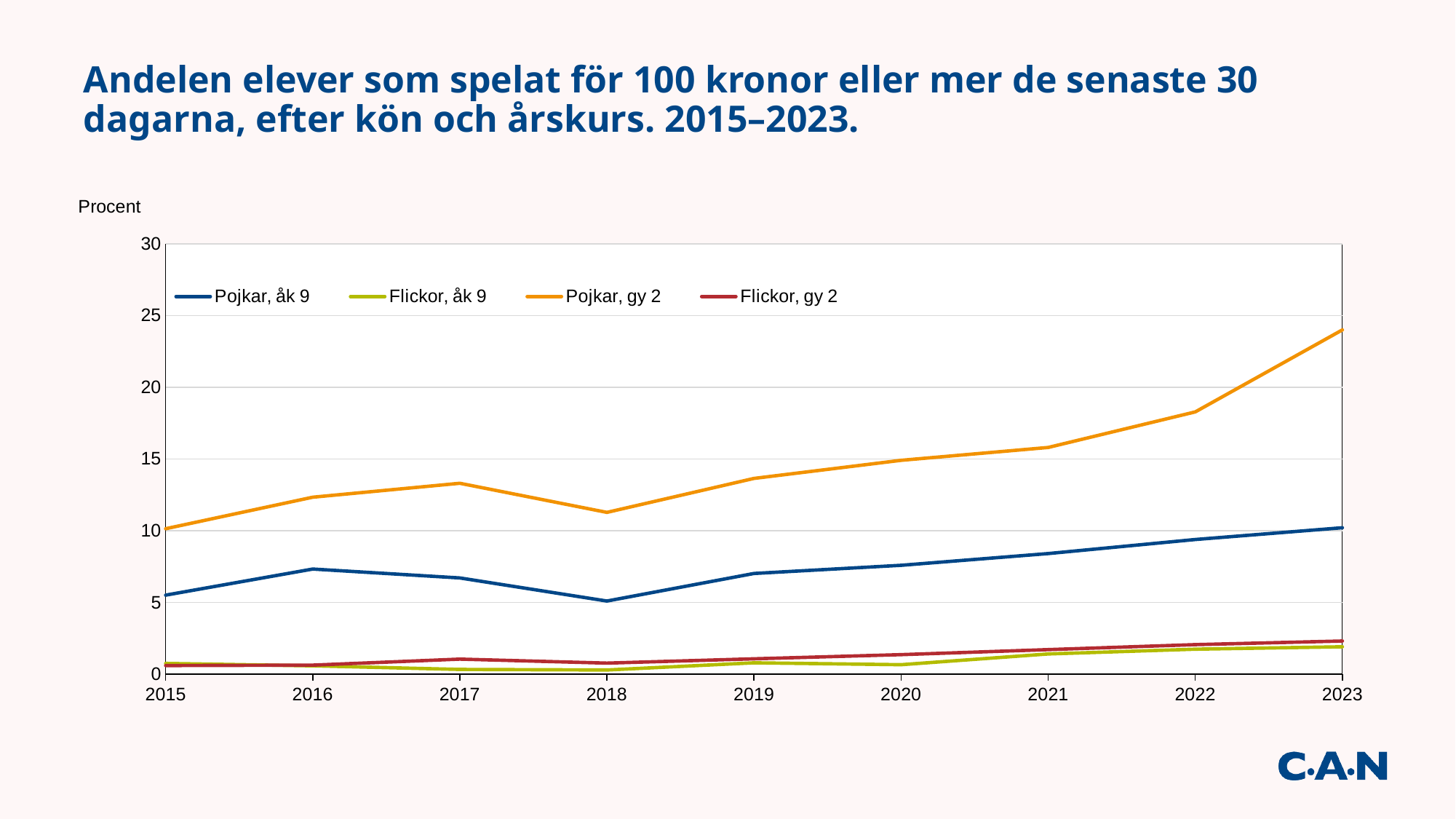
Which is larger in 2020, Pojkar, gy 2 or Pojkar, åk 9? Pojkar, gy 2 How many years are plotted along the x axis? 9 Is the value for Pojkar, gy 2 in 2023 greater or less than 20? greater In which year does the Pojkar, åk 9 series reach its lowest value? 2018 Is the value for Pojkar, gy 2 in 2018 greater or less than 10? greater How many series does the legend list? 4 Is the value for Flickor, gy 2 in 2023 greater or less than 5? less Which series has the highest value in 2023? Pojkar, gy 2 What kind of chart is shown on the slide? Line chart Does the Pojkar, gy 2 series rise or fall from 2018 to 2023? Rise Which series has the lowest value in 2018? Flickor, åk 9 In which year does the Pojkar, gy 2 series reach its highest value? 2023